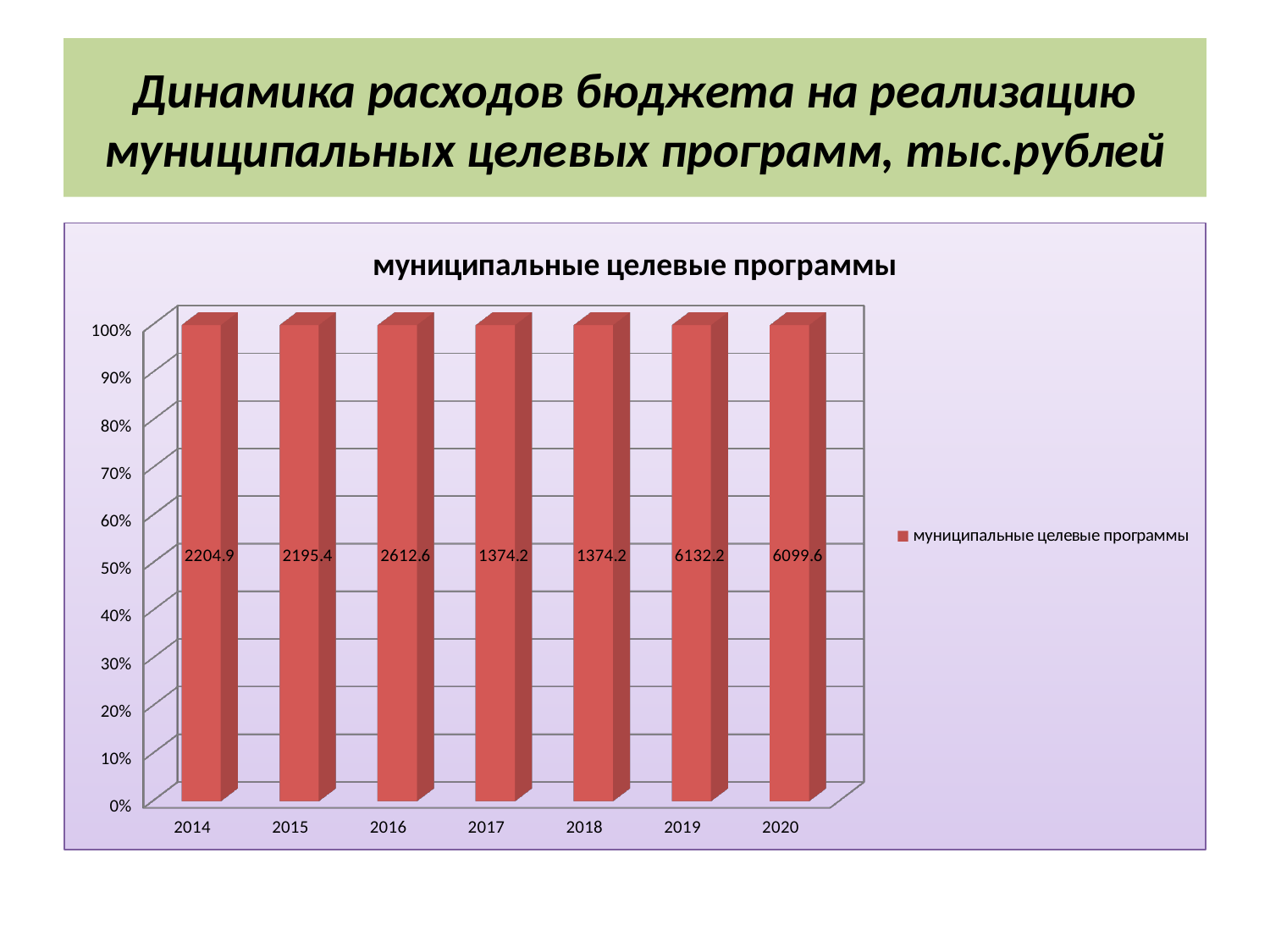
Which has the larger labelled value, 2016 or 2014? 2016 What is the data label value for 2019? 6132.2 What kind of chart is shown? bar chart How many series does the legend list? 1 What is the data label value for 2017? 1374.2 What is the difference between the labelled values for 2016 and 2017? 1238.4 What is the title of the chart? муниципальные целевые программы What is the difference between the labelled values for 2019 and 2020? 32.6 Which year has the highest labelled value? 2019 What is the data label value for 2020? 6099.6 How many years are shown on the x axis? 7 What is the data label value for 2014? 2204.9